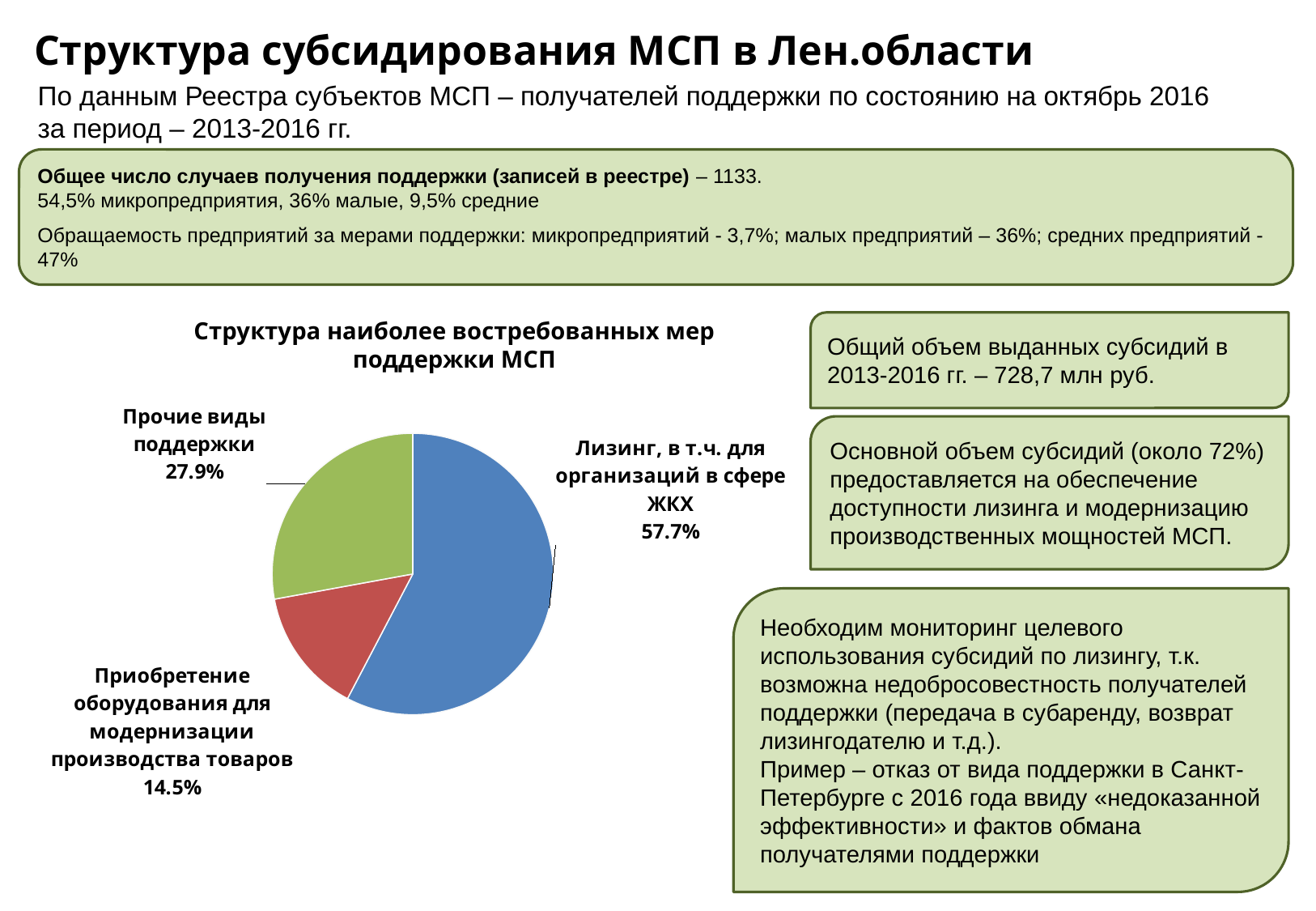
Which category has the smallest slice of the pie? Приобретение оборудования для модернизации производства товаров What share of the pie does the slice "Лизинг, в т.ч. для организаций в сфере ЖКХ" have? 57.7% What is the difference in percentage points between "Лизинг, в т.ч. для организаций в сфере ЖКХ" and "Прочие виды поддержки"? 29.8 What colour is the slice for "Лизинг, в т.ч. для организаций в сфере ЖКХ"? Blue Which category has the largest slice of the pie? Лизинг, в т.ч. для организаций в сфере ЖКХ What is the value shown for "Приобретение оборудования для модернизации производства товаров"? 14.5% What is the difference in percentage points between "Прочие виды поддержки" and "Приобретение оборудования для модернизации производства товаров"? 13.4 Which is larger: the share for "Прочие виды поддержки" or for "Приобретение оборудования для модернизации производства товаров"? Прочие виды поддержки What is the title of the chart? Структура наиболее востребованных мер поддержки МСП What is the value shown for "Прочие виды поддержки"? 27.9% How many slices does the pie chart have? 3 What type of chart is shown on the slide? Pie chart